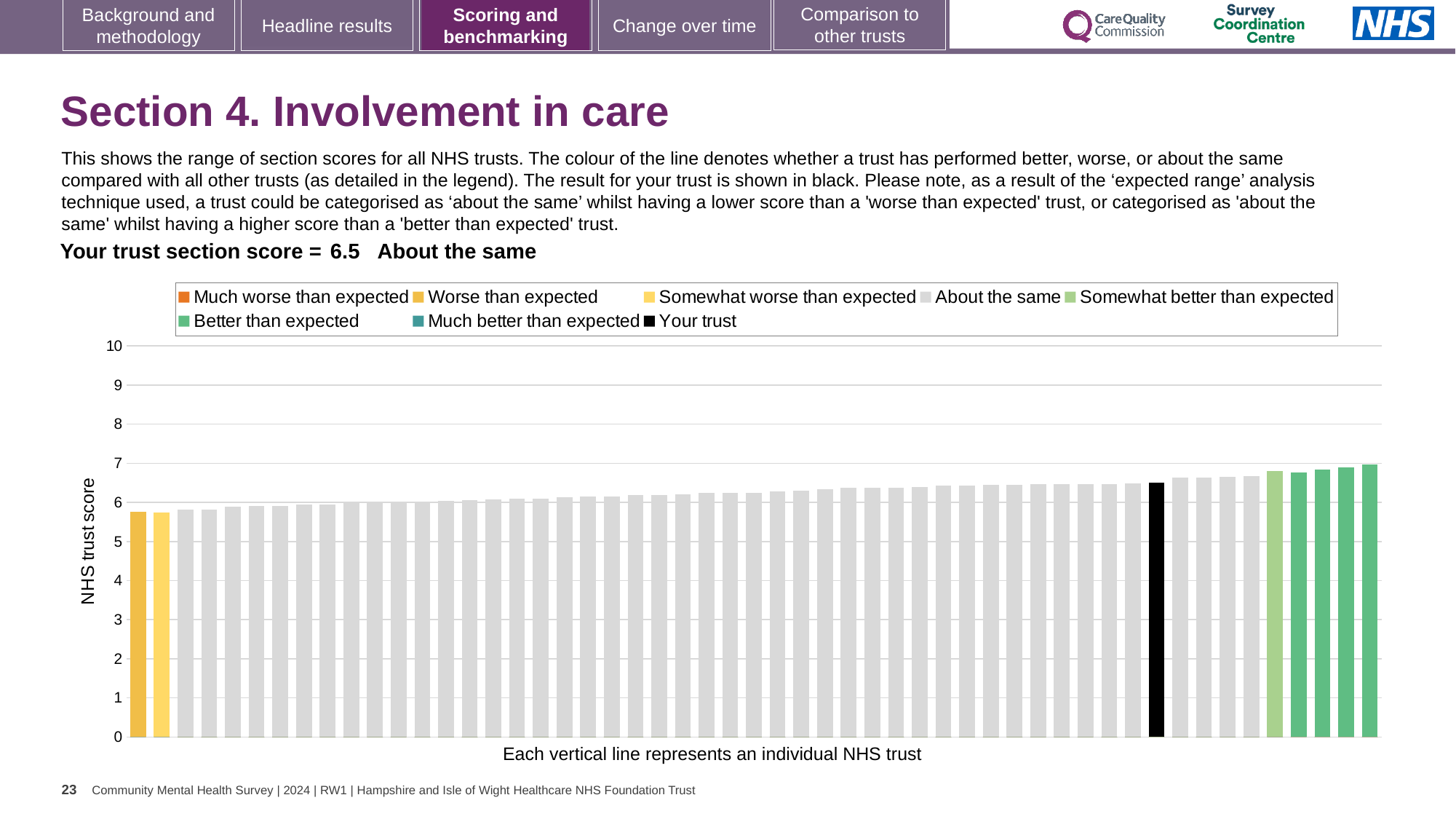
Is the value for your trust (the black bar) greater or less than 6? greater How many bars are coloured as 'Somewhat better than expected'? 1 What is the label of the y axis? NHS trust score How many entries does the legend list? 8 Which is higher, the black bar for your trust or the leftmost bar? the black bar for your trust Is the value of the rightmost bar greater or less than 6? greater How many bars are coloured as 'Better than expected'? 4 Do the bar values rise or fall from left to right along the x axis? rise Which category is your trust's section score placed in? About the same What kind of chart is shown on the slide? bar chart What is the section score for your trust? 6.5 Is the value of the leftmost bar greater or less than 6? less